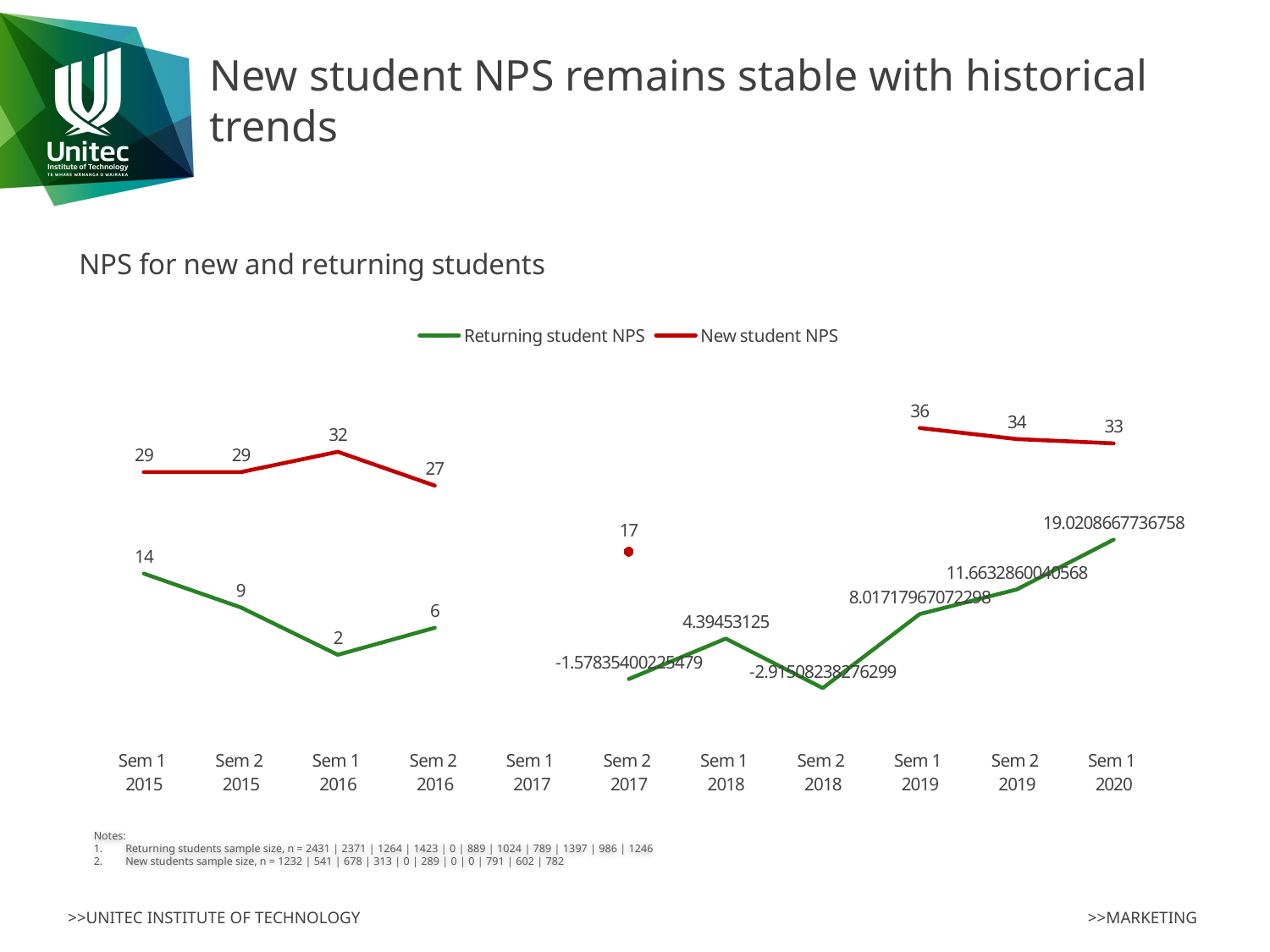
What is the Returning student NPS for Sem 1 2020? 19.0208667736758 In which semester is the Returning student NPS lowest? Sem 2 2018 What is the difference between the New student NPS in Sem 1 2016 and Sem 2 2016? 5 In Sem 1 2020, which is larger: the Returning student NPS or the New student NPS? New student NPS What is the Returning student NPS for Sem 1 2015? 14 How many semesters are shown on the x axis? 11 What is the New student NPS for Sem 2 2017? 17 What kind of chart is shown on the slide? Line chart In which semester is the New student NPS highest? Sem 1 2019 Does the New student NPS rise or fall from Sem 1 2019 to Sem 1 2020? Fall What is the New student NPS for Sem 1 2019? 36 How many series does the legend list? 2